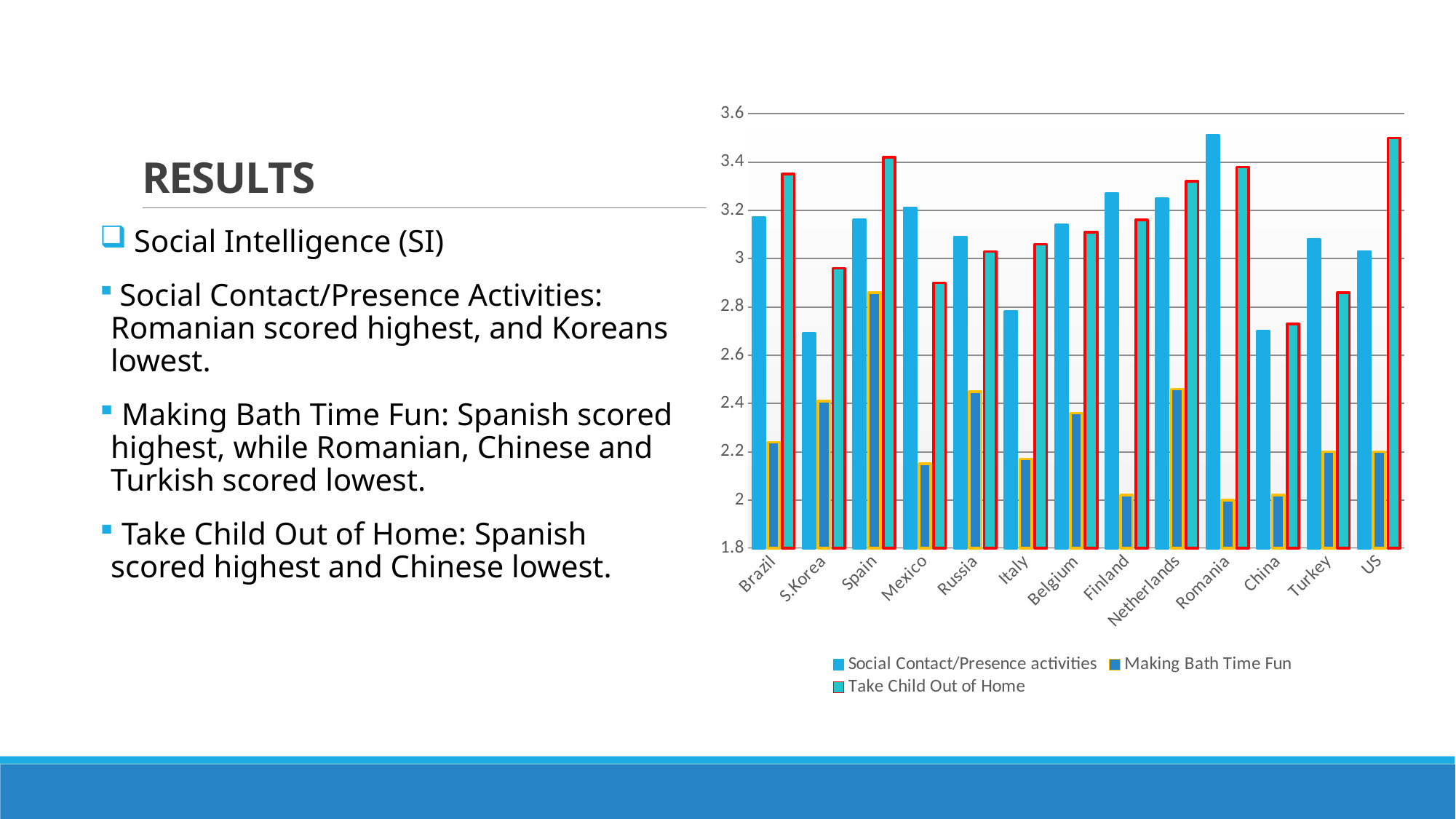
Which country has the lowest value for Take Child Out of Home? China Which country has the highest value for Social Contact/Presence activities? Romania Which country has the highest value for Making Bath Time Fun? Spain For Romania, which is larger: Social Contact/Presence activities or Take Child Out of Home? Social Contact/Presence activities Is the value for Making Bath Time Fun in Finland greater or less than 2.2? less What kind of chart is shown on the slide? bar chart How many countries are shown on the x axis of the chart? 13 For Brazil, which is larger: Social Contact/Presence activities or Take Child Out of Home? Take Child Out of Home Is the value for Take Child Out of Home in Netherlands greater or less than 3.2? greater Is the value for Take Child Out of Home in China greater or less than 2.8? less How many series does the chart legend list? 3